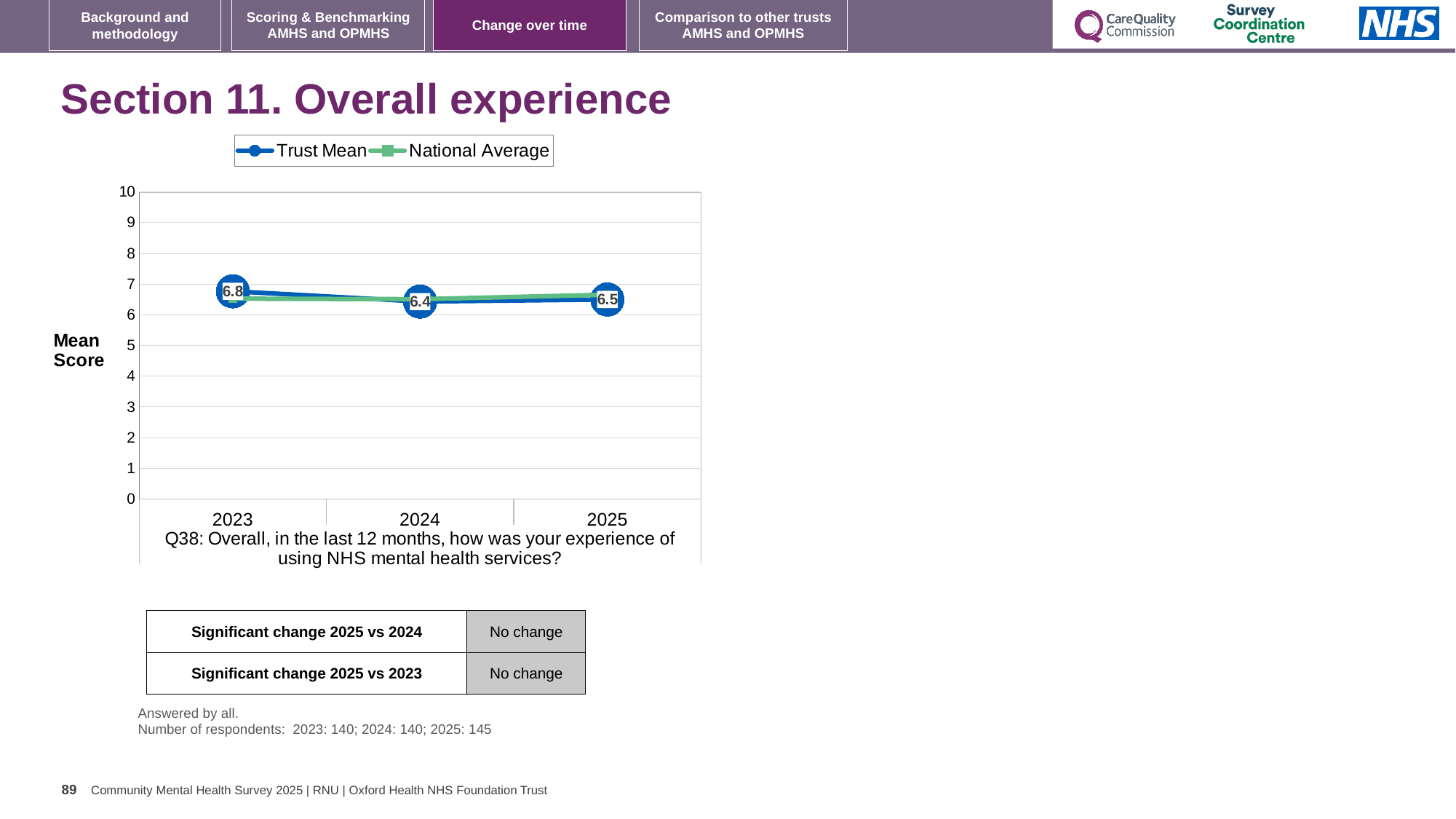
What is the Trust Mean score for 2023? 6.8 How many series does the legend list? 2 What kind of chart is shown on the slide? Line chart What is the difference between the Trust Mean in 2023 and in 2024? 0.4 What is the Trust Mean score for 2024? 6.4 In which year is the Trust Mean highest? 2023 Is the Trust Mean higher in 2023 or in 2025? 2023 Is the National Average value for 2024 greater or less than 5? greater What is the label on the y axis of the chart? Mean Score How many years are plotted on the x axis? 3 What is the Trust Mean score for 2025? 6.5 In which year is the Trust Mean lowest? 2024